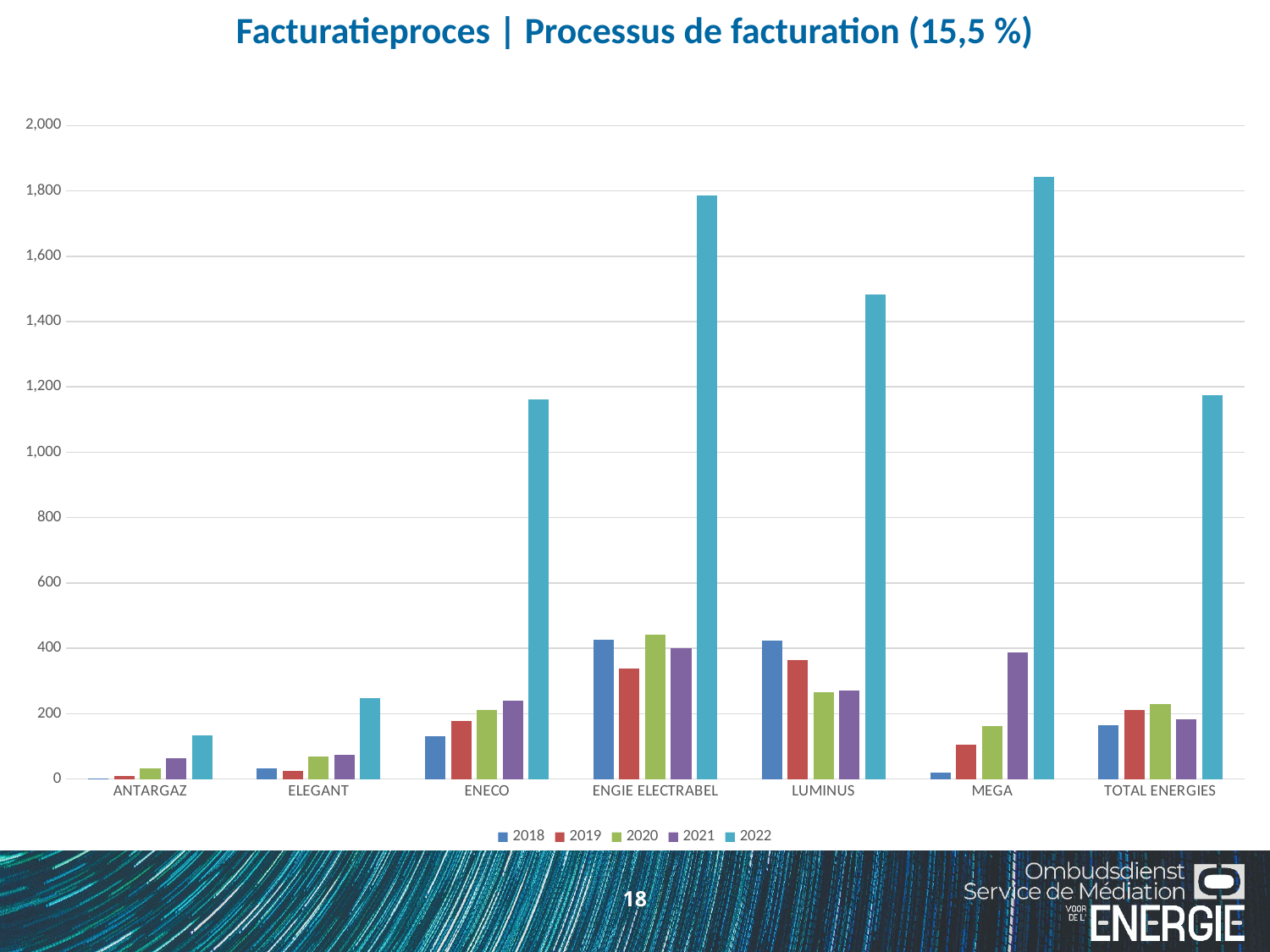
For ANTARGAZ, do the values rise or fall from 2018 to 2022? rise Which supplier has the highest 2022 value? MEGA Which year is the last series listed in the legend? 2022 What kind of chart is shown on the slide? Bar chart Which supplier has the lowest 2022 value? ANTARGAZ Is the 2022 value for ELEGANT greater or less than 200? greater How many series does the legend list? 5 How many supplier categories are shown on the x axis? 7 Which is larger: the 2022 value for ENGIE ELECTRABEL or the 2022 value for LUMINUS? ENGIE ELECTRABEL Is the 2022 value for LUMINUS greater or less than 1,400? greater Is the 2022 value for MEGA greater or less than 1,800? greater